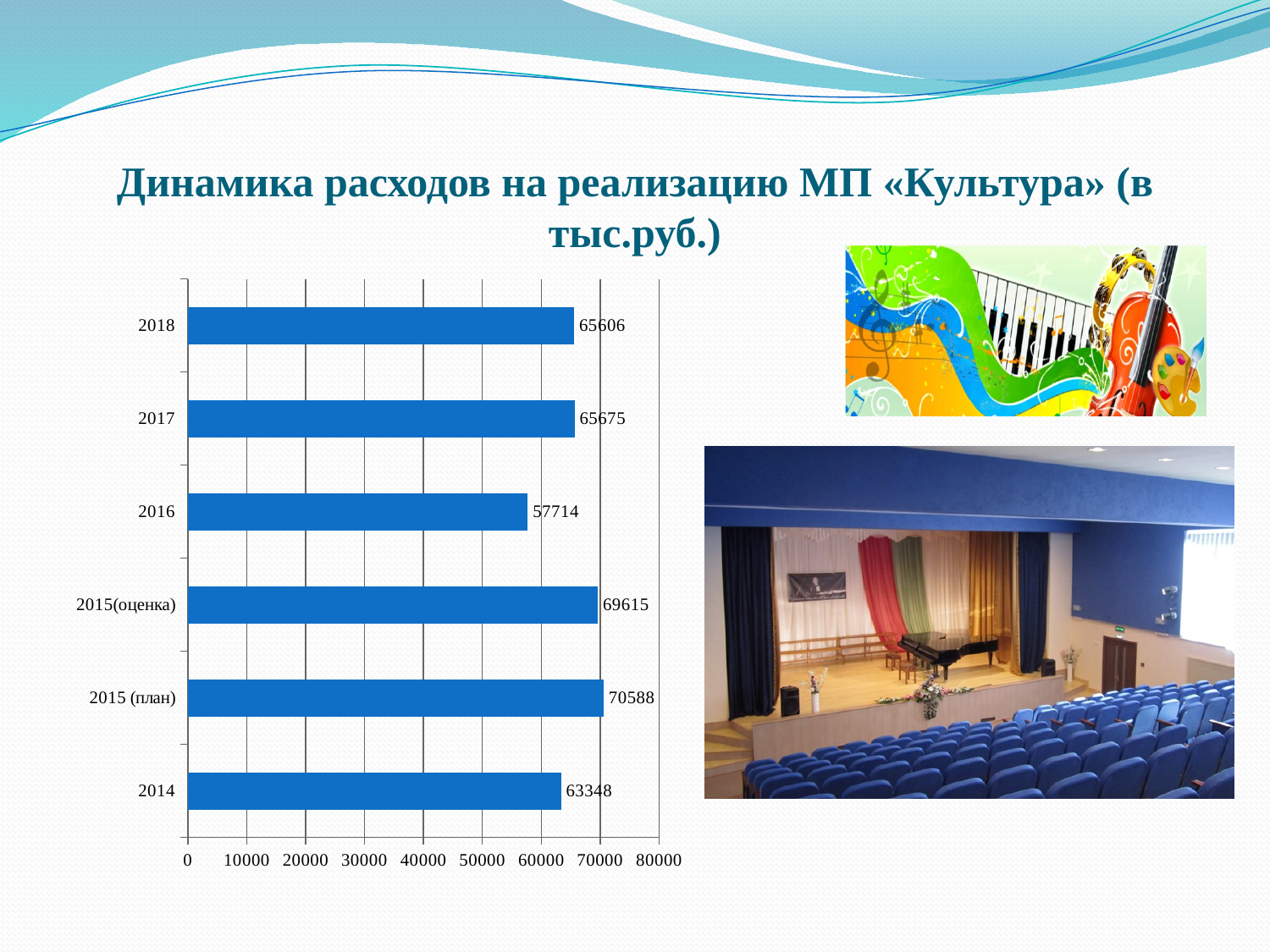
Is the value for 2016 greater or less than 60000? less What type of chart is shown on the slide? bar chart What is the value for 2015 (план)? 70588 What is the difference between the values for 2015 (план) and 2015(оценка)? 973 Which is larger, the value for 2014 or the value for 2016? 2014 How many categories are shown on the chart? 6 What is the difference between the values for 2017 and 2016? 7961 What is the value for 2014? 63348 What is the value for 2018? 65606 What is the value for 2016? 57714 Which category has the highest value? 2015 (план) Which category has the lowest value? 2016